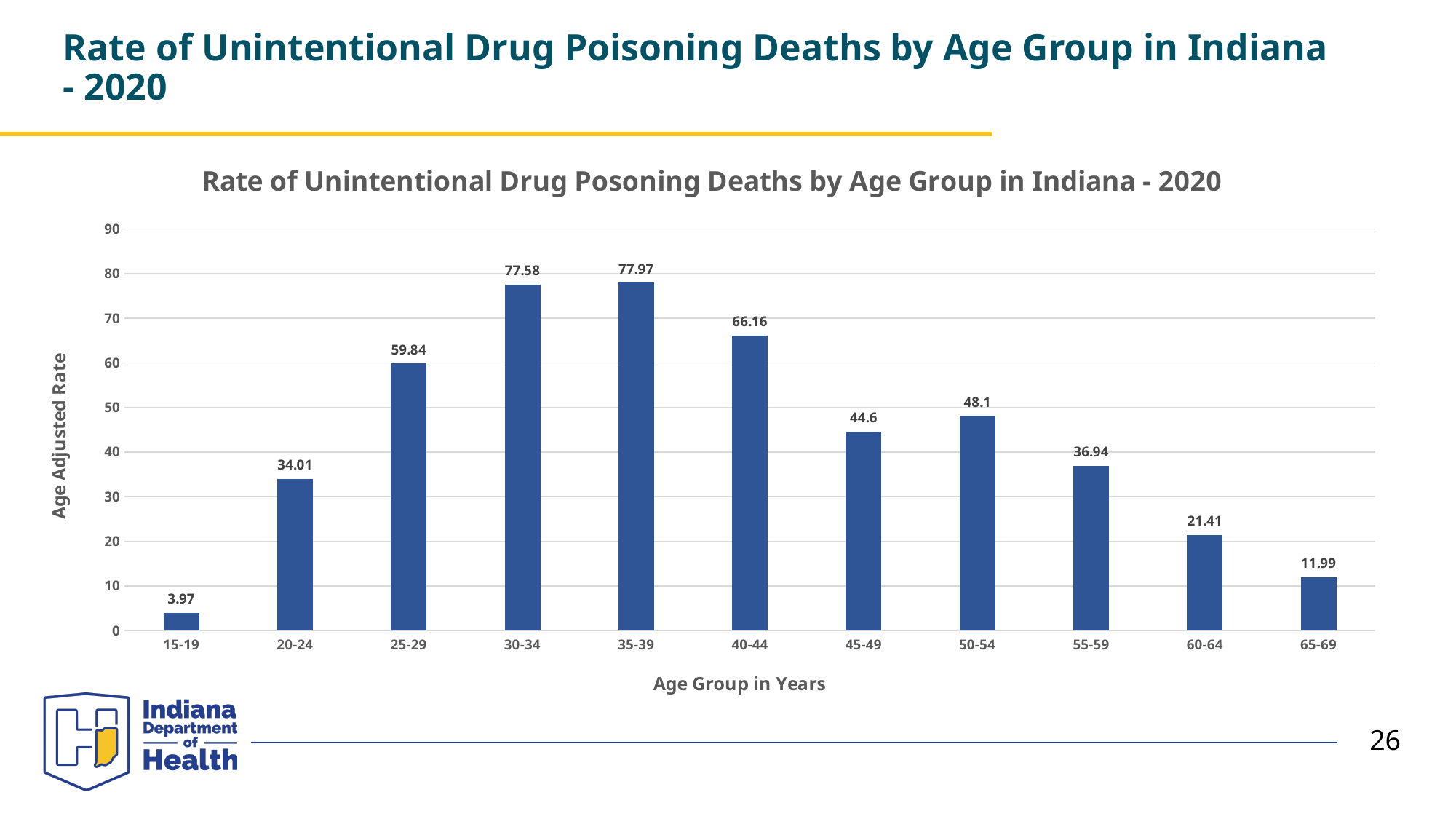
What is the difference between the rates for the 50-54 and 55-59 age groups? 11.16 Which age group has a higher rate, 25-29 or 40-44? 40-44 From the 50-54 age group to the 65-69 age group, do the values rise or fall? fall What is the difference between the rates for the 40-44 and 45-49 age groups? 21.56 What kind of chart is shown on the slide? bar chart What is the age adjusted rate for the 45-49 age group? 44.6 What is the age adjusted rate for the 30-34 age group? 77.58 Which age group has the highest age adjusted rate? 35-39 Which age group has the lowest age adjusted rate? 15-19 What is the age adjusted rate for the 60-64 age group? 21.41 Is the value for the 20-24 age group greater or less than 30? greater How many age groups are shown on the x axis? 11